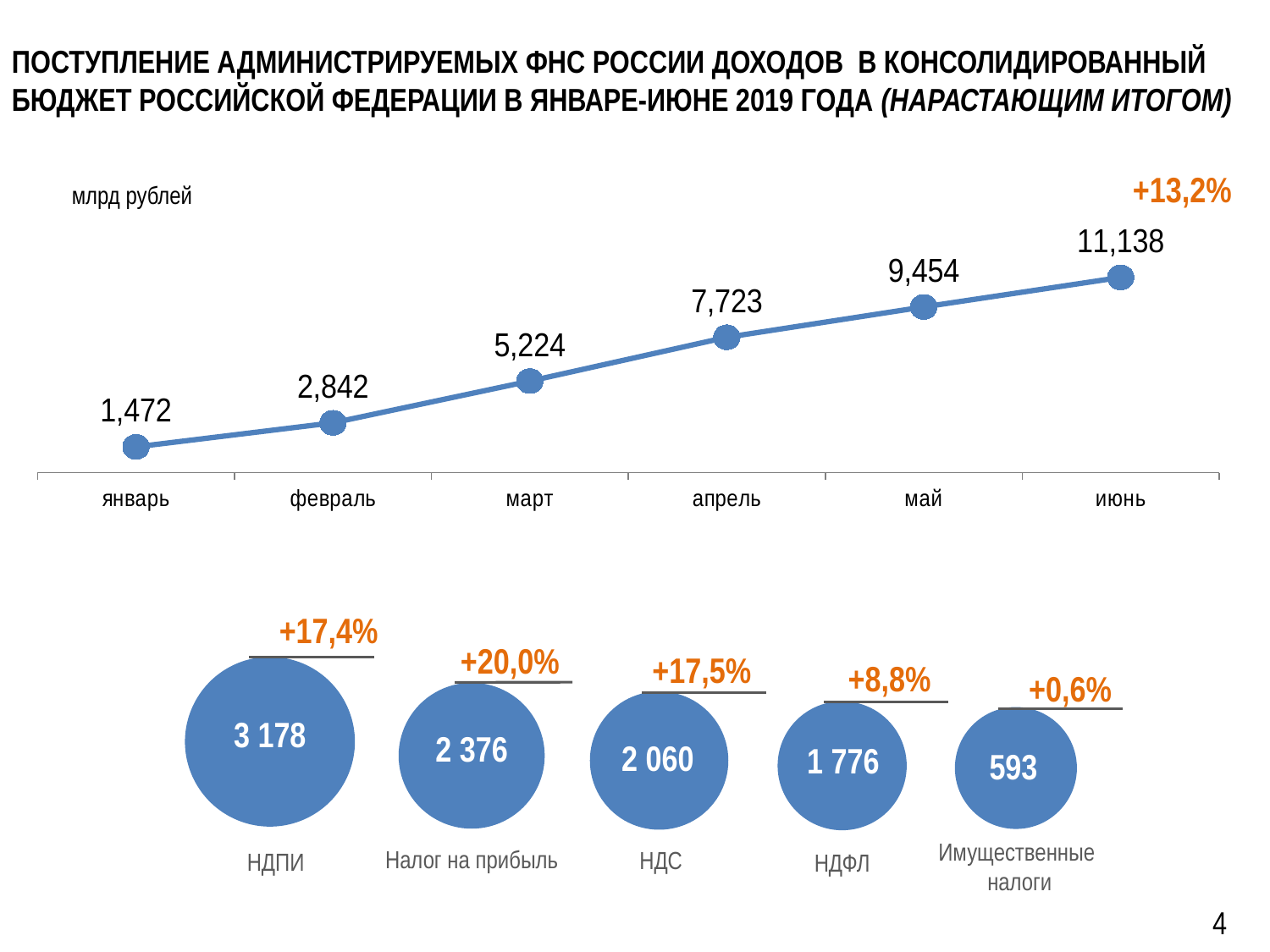
In the top line chart, what is the value for июнь? 11,138 How many data points are plotted in the top line chart? 6 In the bottom bubble chart, which is larger: Налог на прибыль or НДФЛ? Налог на прибыль In the top line chart, what growth percentage is shown next to the июнь value? +13,2% In the top line chart, what is the difference between the values for май and апрель? 1,731 In the top line chart, what is the value for март? 5,224 In the bottom bubble chart, what growth percentage is shown above Имущественные налоги? +0,6% What kind of chart is the top chart on the slide? line chart In the top line chart, which month has the lowest value? январь In the bottom bubble chart, which category has the highest value? НДПИ In the top line chart, do the values rise or fall from январь to июнь? rise In the bottom bubble chart, what is the value for НДС? 2 060